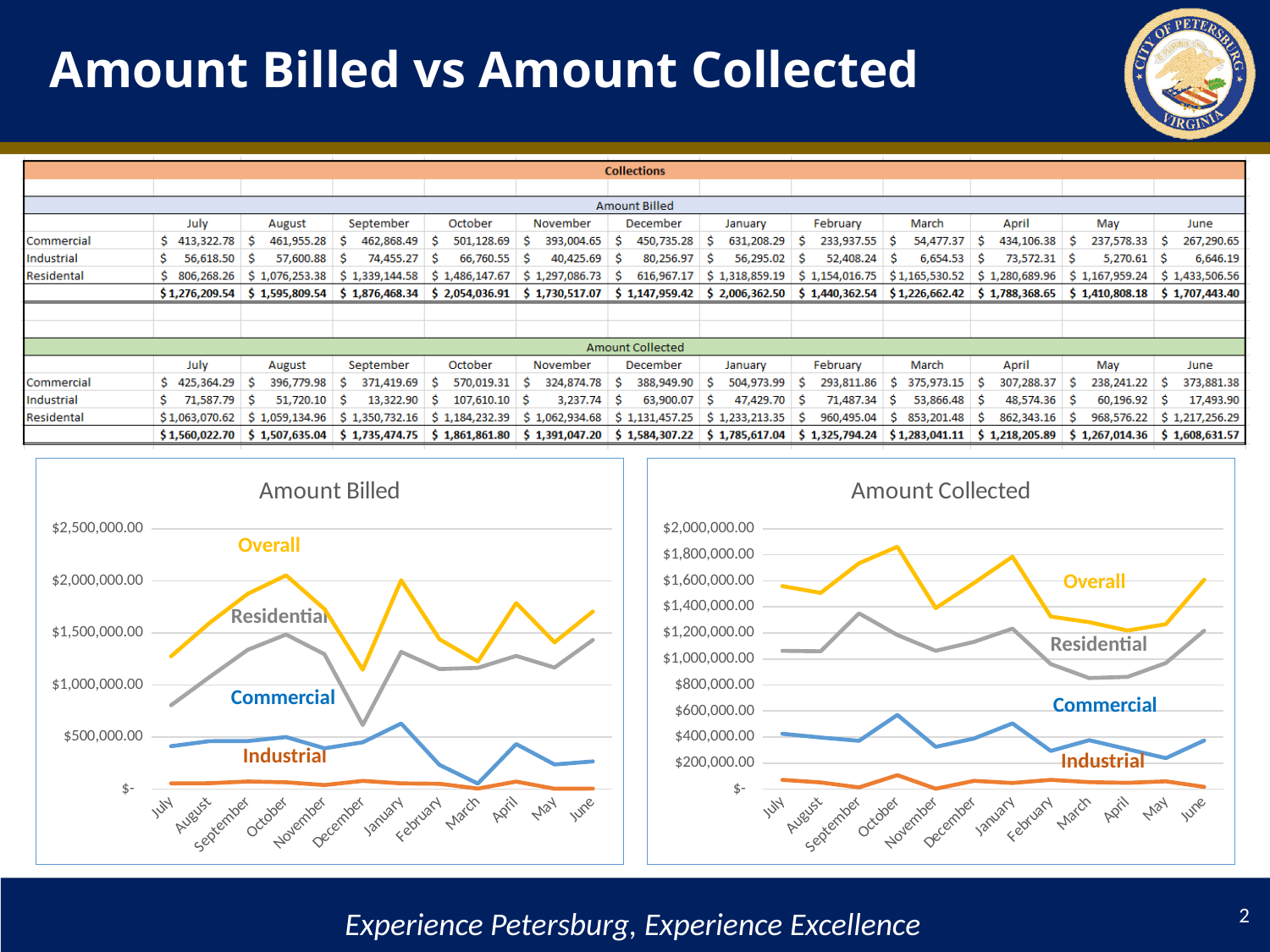
What is the Overall amount billed in October? $2,054,036.91 In the Amount Collected chart, in which month does the Overall line reach its highest value? October What is the Residential amount collected in June? $1,217,256.29 In the Amount Collected chart, in which month is the Overall line at its lowest? April How many lines are plotted in the Amount Billed chart? 4 What type of chart is the Amount Billed chart? line chart How many months are shown on the x axis of the Amount Collected chart? 12 What is the difference between the Overall amount billed in October and the Overall amount collected in October? $192,175.11 In the Amount Billed chart, is the Commercial value for January greater or less than $500,000.00? greater In the Amount Billed chart, in which month does the Overall line reach its highest value? October Which is larger, the Overall amount billed in July or the Overall amount collected in July? Amount Collected In the Amount Billed chart, in which month is the Overall line at its lowest? December